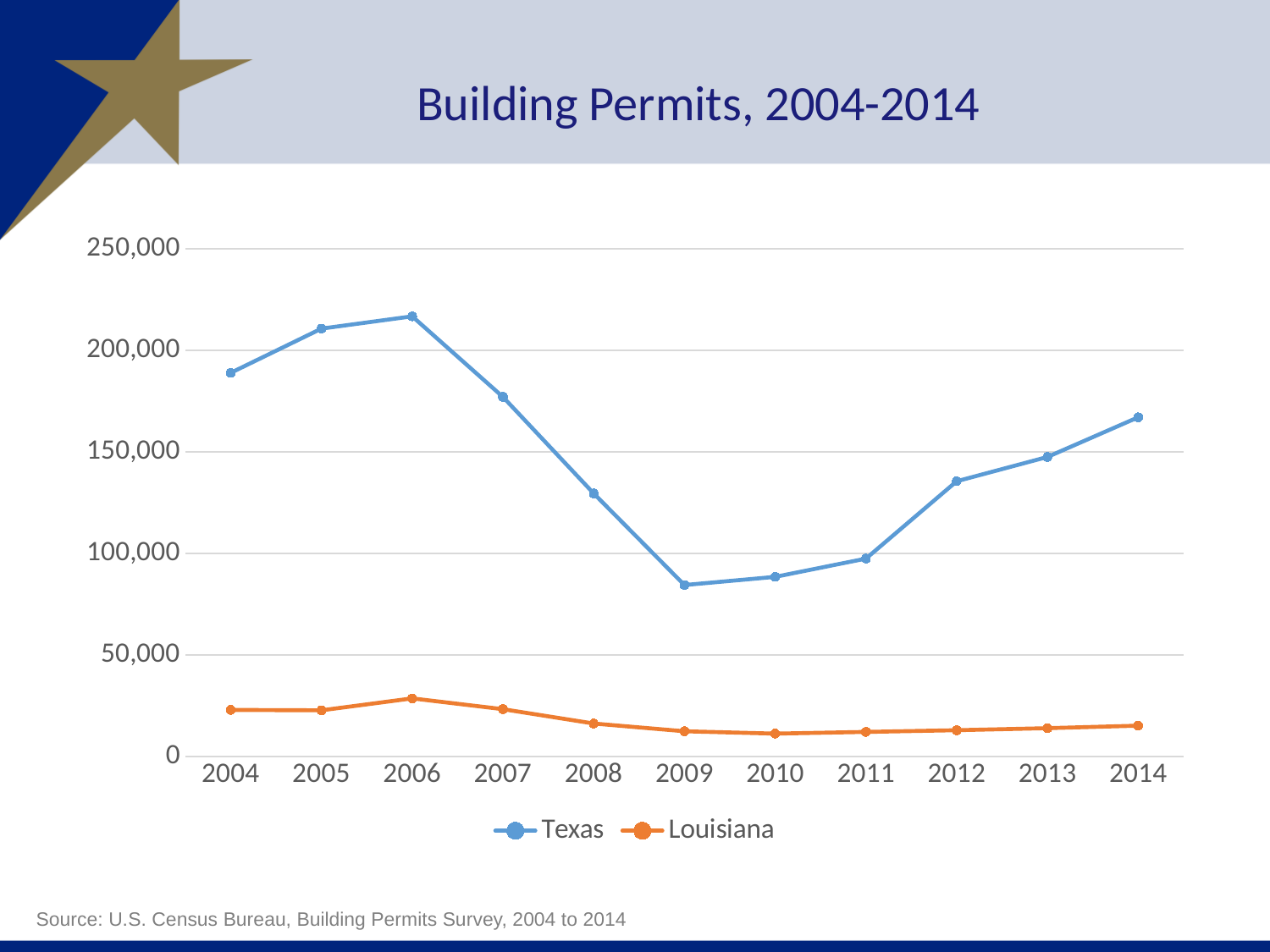
Does the Texas series rise or fall between 2006 and 2009? Fall What is the title of the chart? Building Permits, 2004-2014 Which is larger, the Texas value in 2005 or the Texas value in 2014? 2005 Is the value for Texas in 2006 greater or less than 200,000? greater What kind of chart is shown on the slide? Line chart How many years are plotted along the x axis? 11 In which year does the Texas series reach its lowest value? 2009 Is the value for Texas in 2009 greater or less than 100,000? less Is the value for Texas in 2014 greater or less than 150,000? greater In which year does the Texas series reach its highest value? 2006 In which year does the Louisiana series reach its highest value? 2006 How many series does the legend list? 2